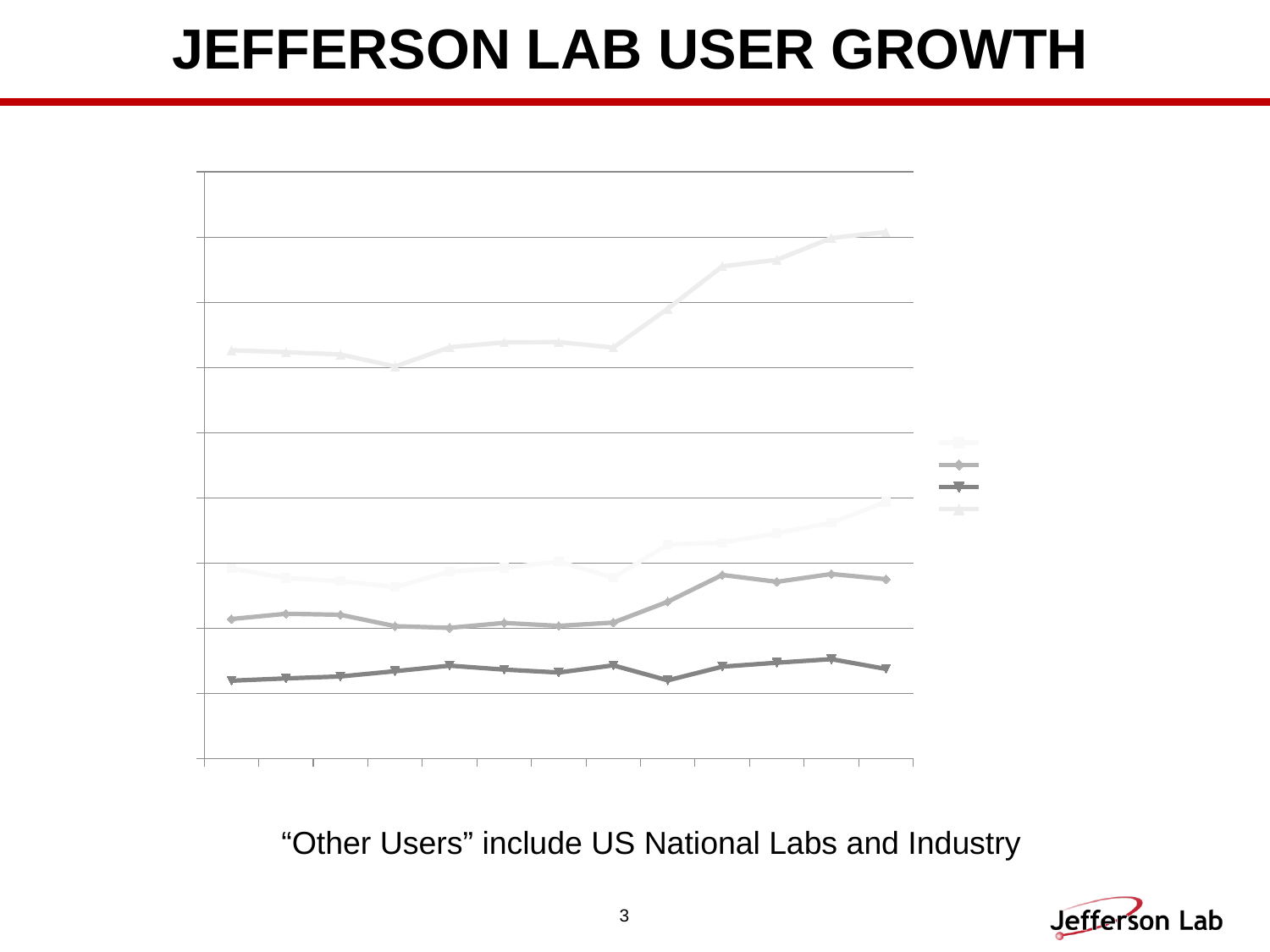
What kind of chart is shown on the slide? line chart How many series does the legend list? 4 Does the topmost line in the chart rise or fall overall from left to right? rise What is the title of the slide containing the chart? JEFFERSON LAB USER GROWTH How many data points does each line in the chart have? 13 How many lines are plotted in the chart? 4